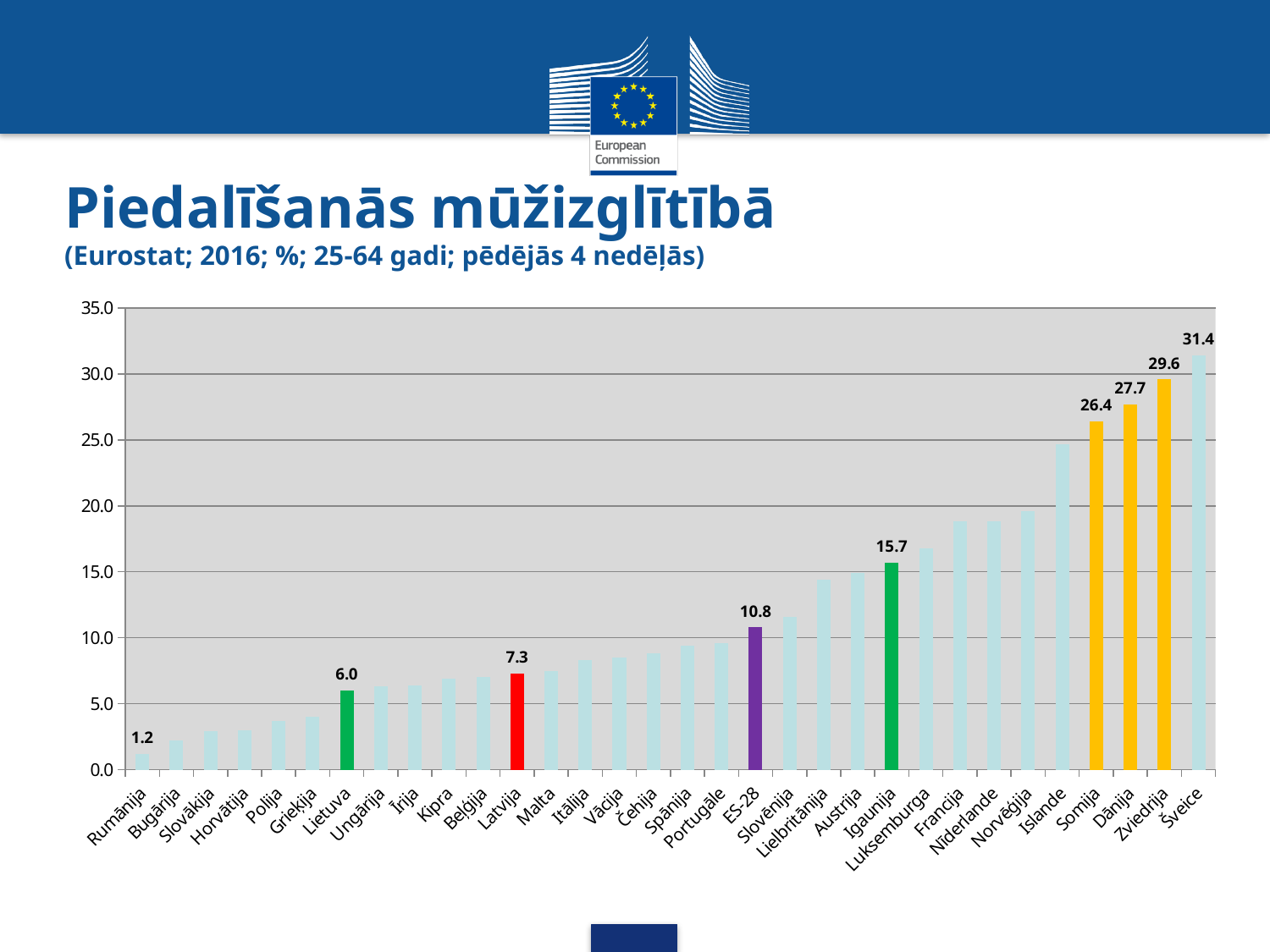
What is the value for Latvija? 7.3 How many countries/categories are shown on the x axis? 32 Is the value for Islande greater or less than 20.0? greater What kind of chart is shown on the slide? bar chart What is the difference between the values for ES-28 and Latvija? 3.5 Is the value for Slovēnija greater or less than 15.0? less What is the difference between the values for Latvija and Lietuva? 1.3 What is the value for ES-28? 10.8 Which country has the lowest value? Rumānija Which country has the highest value? Šveice Which is larger, the value for Latvija or the value for ES-28? ES-28 What is the value for Igaunija? 15.7